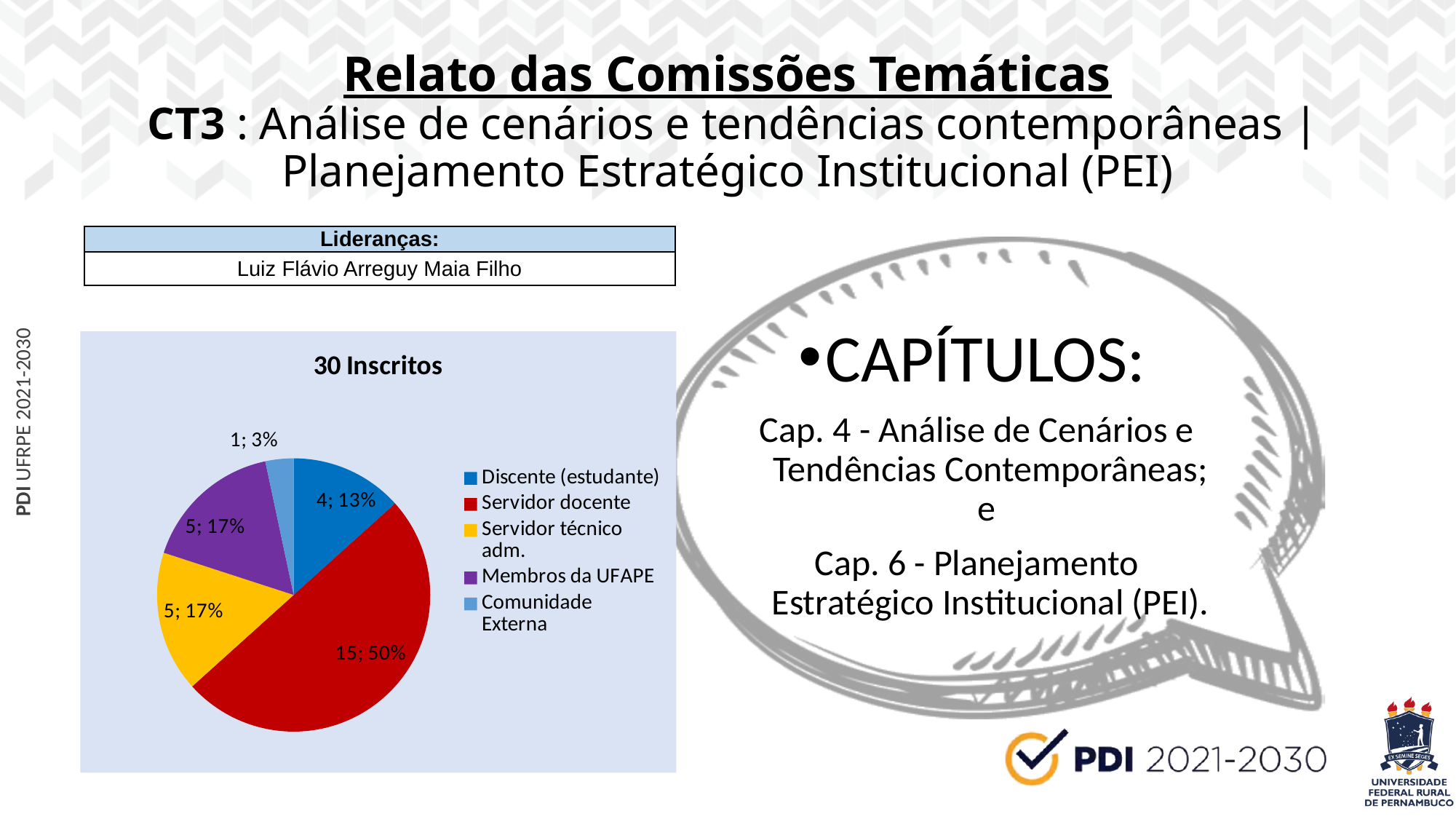
How many inscritos are in the Discente (estudante) category? 4 What is the title of the chart? 30 Inscritos What percentage of the pie is Comunidade Externa? 3% What kind of chart is shown on the slide? pie chart How many inscritos are in the Servidor docente category? 15 How many slices does the pie chart have? 5 Which is larger, the count for Servidor docente or the count for Membros da UFAPE? Servidor docente Which category has the smallest slice of the pie? Comunidade Externa What is the difference in count between Servidor docente and Discente (estudante)? 11 Which category has the largest slice of the pie? Servidor docente What share of the pie does Servidor docente represent? 50% How many entries does the chart legend list? 5